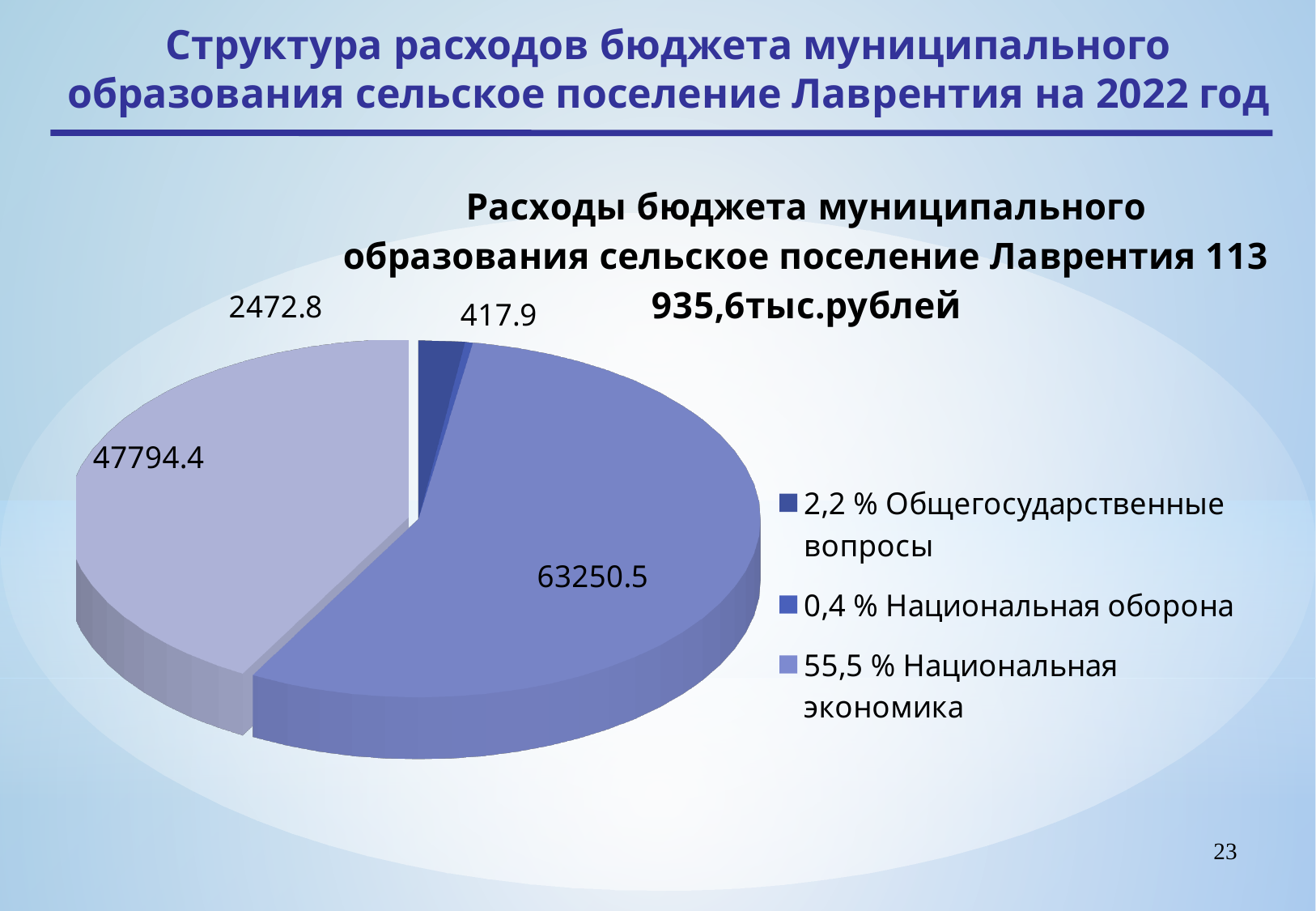
How many slices does the pie chart have? 4 What kind of chart is shown on the slide? Pie chart What share of the pie does Национальная экономика represent according to the legend? 55,5 % Which is larger, Общегосударственные вопросы or Национальная оборона? Общегосударственные вопросы What is the difference between the slice labelled 63250.5 and the slice labelled 47794.4? 15456.1 What is the value shown for Национальная оборона? 417.9 What total amount of budget expenditure is stated in the chart title? 113 935,6 тыс.рублей What is the value of the largest slice in the pie chart? 63250.5 What is the value shown for Национальная экономика? 63250.5 How many entries does the legend of the pie chart list? 3 What is the value shown for Общегосударственные вопросы? 2472.8 What is the value of the smallest slice in the pie chart? 417.9